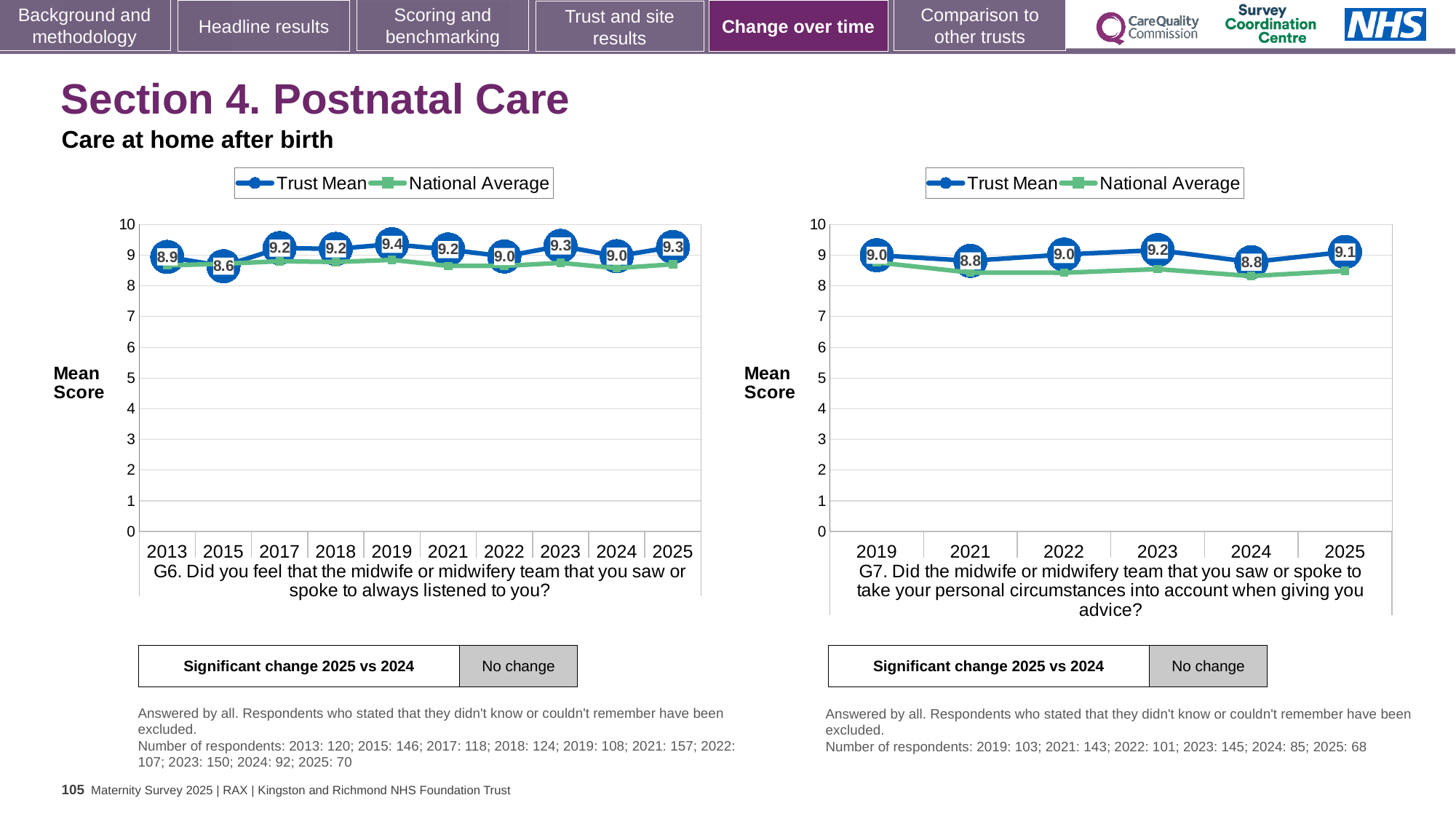
In the left chart (G6), which year has the highest Trust Mean score? 2019 In the left chart (G6), what is the Trust Mean score for 2019? 9.4 In the left chart (G6), what is the Trust Mean score for 2025? 9.3 What kind of chart is the right chart (G7)? line chart In the right chart (G7), which year has the highest Trust Mean score? 2023 In the right chart (G7), what is the Trust Mean score for 2025? 9.1 In the right chart (G7), is the Trust Mean score for 2024 larger or smaller than the score for 2025? smaller In the right chart (G7), what is the Trust Mean score for 2023? 9.2 In the right chart (G7), how many series does the legend list? 2 In the left chart (G6), how many years are plotted on the x axis? 10 In the left chart (G6), which year has the lowest Trust Mean score? 2015 In the left chart (G6), what is the difference between the Trust Mean scores for 2019 and 2015? 0.8